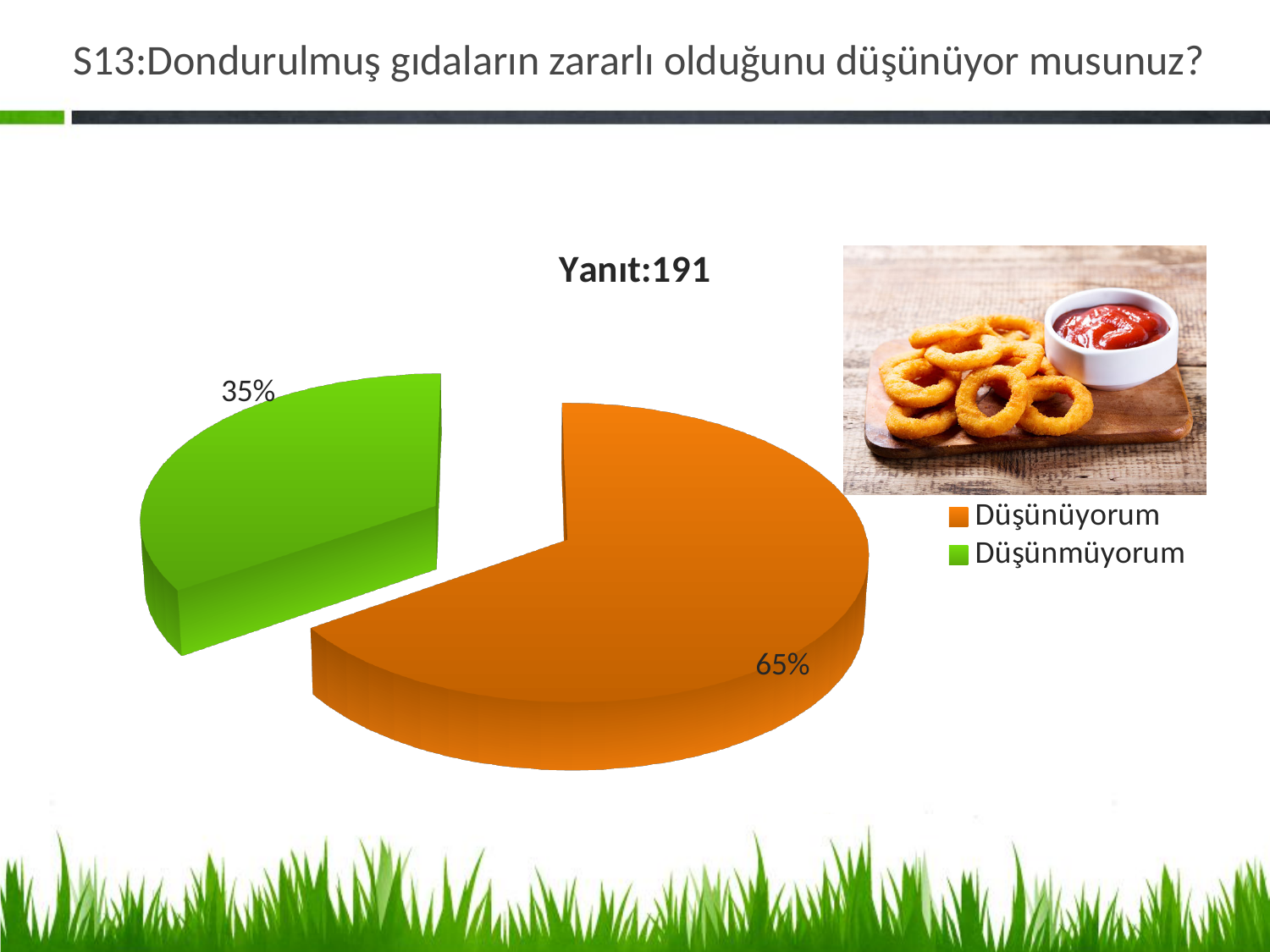
What share of the pie does "Düşünmüyorum" have? 35% What colour is the "Düşünmüyorum" slice? green Which category has the largest slice of the pie? Düşünüyorum How many slices does the pie chart have? 2 What is the difference in percentage points between the "Düşünüyorum" and "Düşünmüyorum" slices? 30 What kind of chart is shown on the slide? pie chart Which slice is larger, "Düşünüyorum" or "Düşünmüyorum"? Düşünüyorum What share of the pie does "Düşünüyorum" have? 65% How many entries does the legend list? 2 Which category has the smallest slice of the pie? Düşünmüyorum What is the title of the chart? Yanıt:191